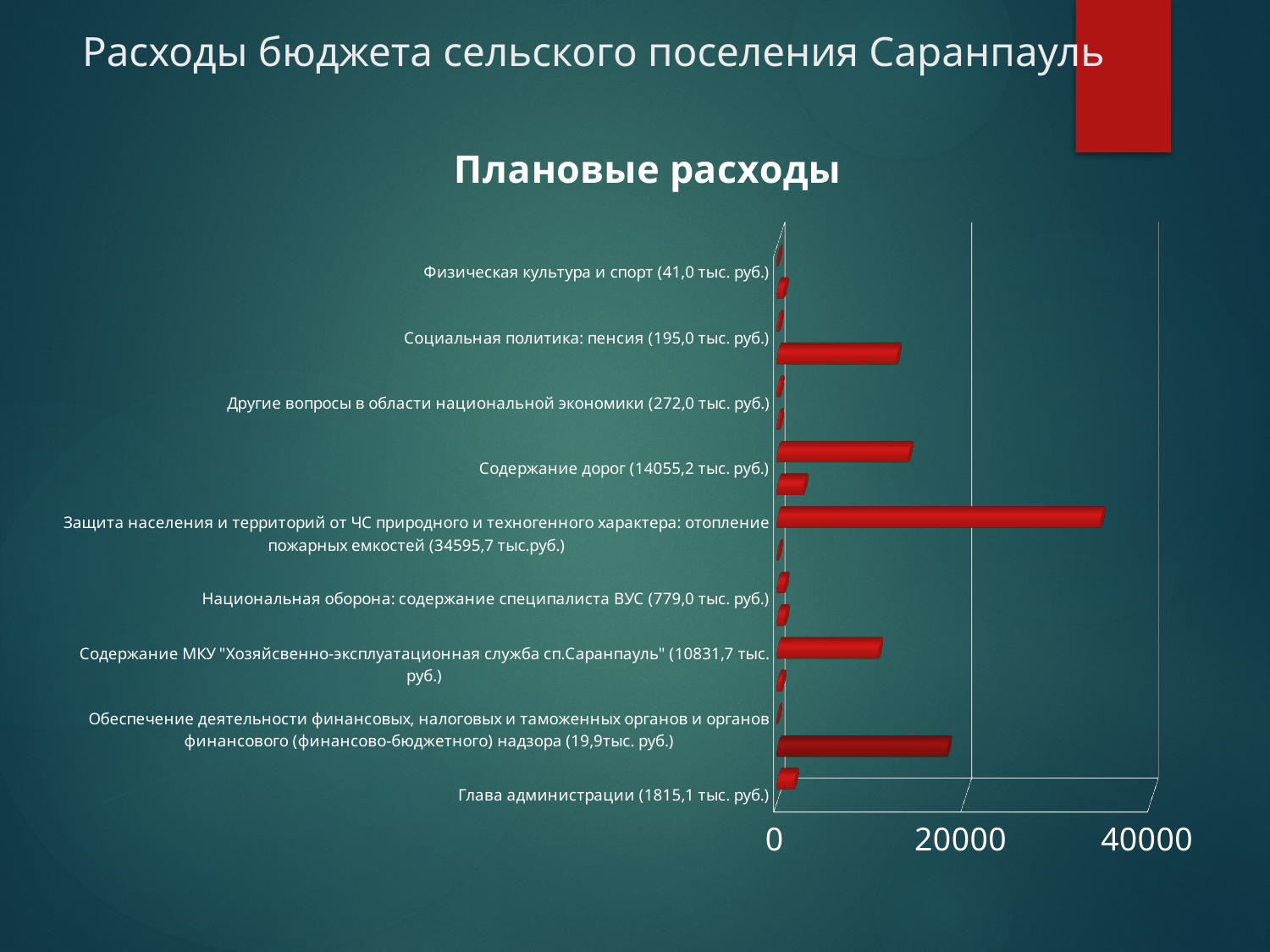
What is the difference between the planned expense for "Содержание дорог" (14055,2) and for "Содержание МКУ" (10831,7), in тыс. руб.? 3223,5 What planned expense amount is given for "Физическая культура и спорт"? 41,0 тыс. руб. Which category has the largest planned expense according to the labels? Защита населения и территорий от ЧС природного и техногенного характера: отопление пожарных емкостей (34595,7 тыс.руб.) What is the title of the chart? Плановые расходы Is the longest bar on the chart greater or less than 20000? greater How many category labels are listed on the chart's vertical axis? 9 What planned expense amount is given for "Национальная оборона: содержание специпалиста ВУС"? 779,0 тыс. руб. What planned expense amount is given for "Глава администрации"? 1815,1 тыс. руб. Which category has the smallest planned expense according to the labels? Обеспечение деятельности финансовых, налоговых и таможенных органов и органов финансового (финансово-бюджетного) надзора (19,9 тыс. руб.) What type of chart is shown on the slide? bar chart What planned expense amount is given for "Содержание дорог"? 14055,2 тыс. руб. Which is larger: the planned expense for "Содержание дорог" or for "Содержание МКУ "Хозяйсвенно-эксплуатационная служба сп.Саранпауль""? Содержание дорог